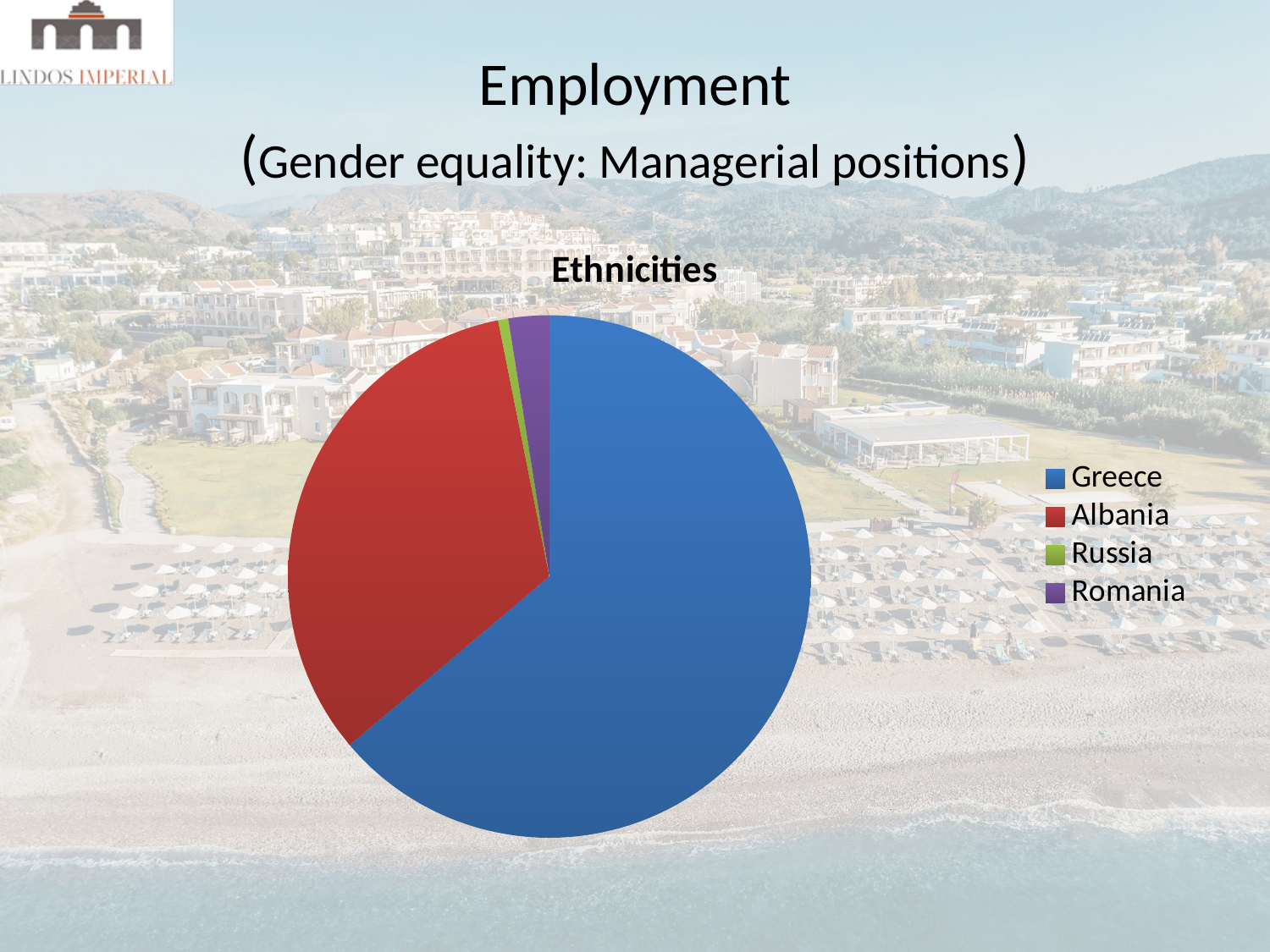
What is the title of the chart? Ethnicities Does the Greece slice account for more or less than half of the pie? more Which category has the smallest slice of the pie? Russia Which slice is larger, Romania or Russia? Romania Which category is listed first in the legend? Greece What type of chart is shown on the slide? pie chart Which slice is larger, Albania or Romania? Albania Which slice is larger, Greece or Albania? Greece Which category has the largest slice of the pie? Greece Which colour represents Albania in the pie chart? red How many categories does the pie chart show? 4